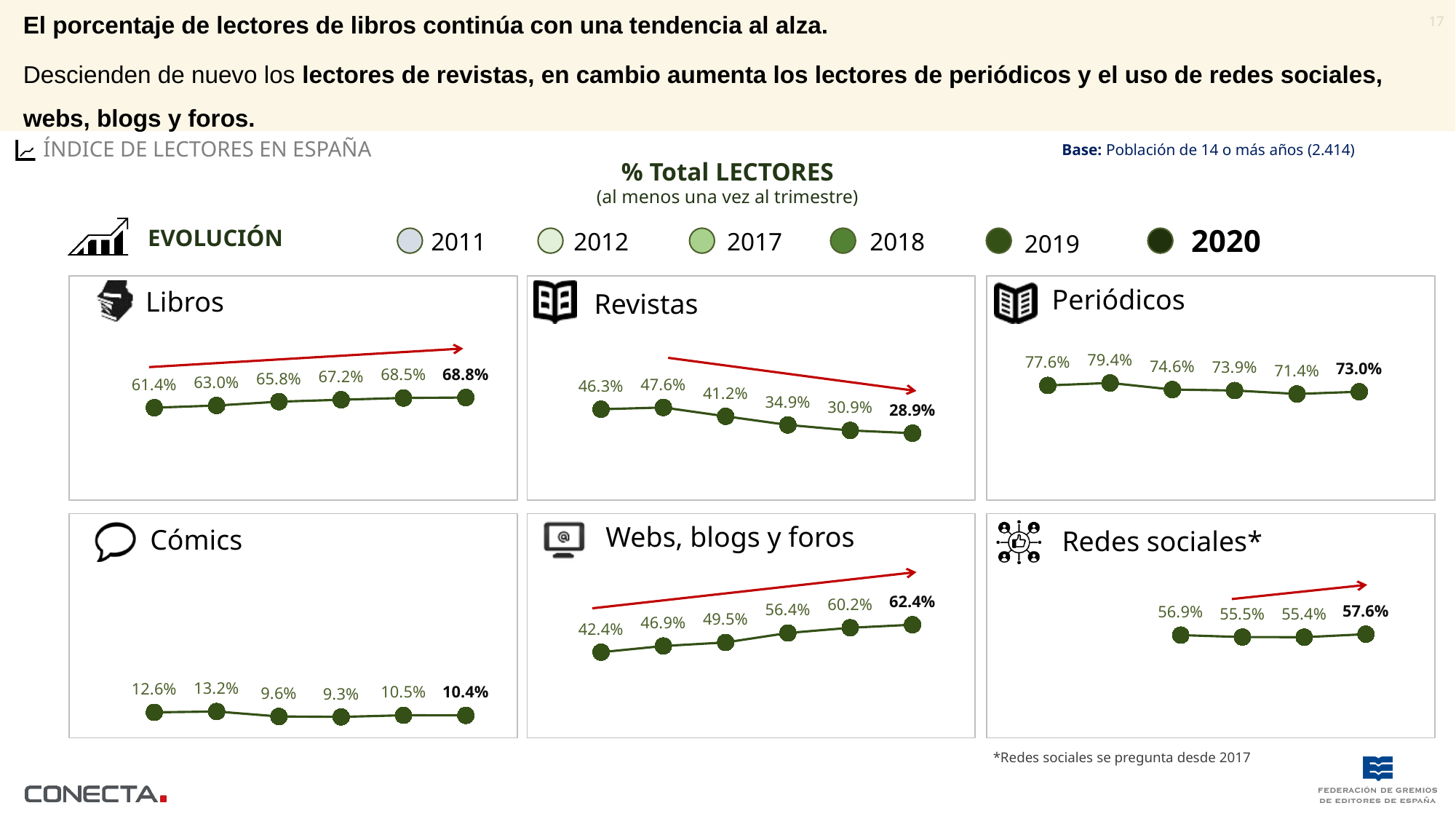
In the Revistas chart, do the values rise or fall from 2012 to 2020? fall How many years does the EVOLUCIÓN legend list? 6 Which is larger: the 2020 value in the Periódicos chart or the 2020 value in the Libros chart? Periódicos (73.0%) In the Revistas chart, what is the value for 2011? 46.3% What kind of chart is used in the Cómics panel? line chart In the Libros chart, what is the value for 2020? 68.8% In the Libros chart, do the values rise or fall from 2011 to 2020? rise In the Redes sociales chart, how many data points are plotted? 4 In the Cómics chart, which year has the lowest value? 2018 In the Periódicos chart, which year has the highest value? 2012 In the Redes sociales chart, what is the difference between the 2020 value and the 2019 value? 2.2% In the Webs, blogs y foros chart, what is the difference between the 2020 value and the 2011 value? 20.0%